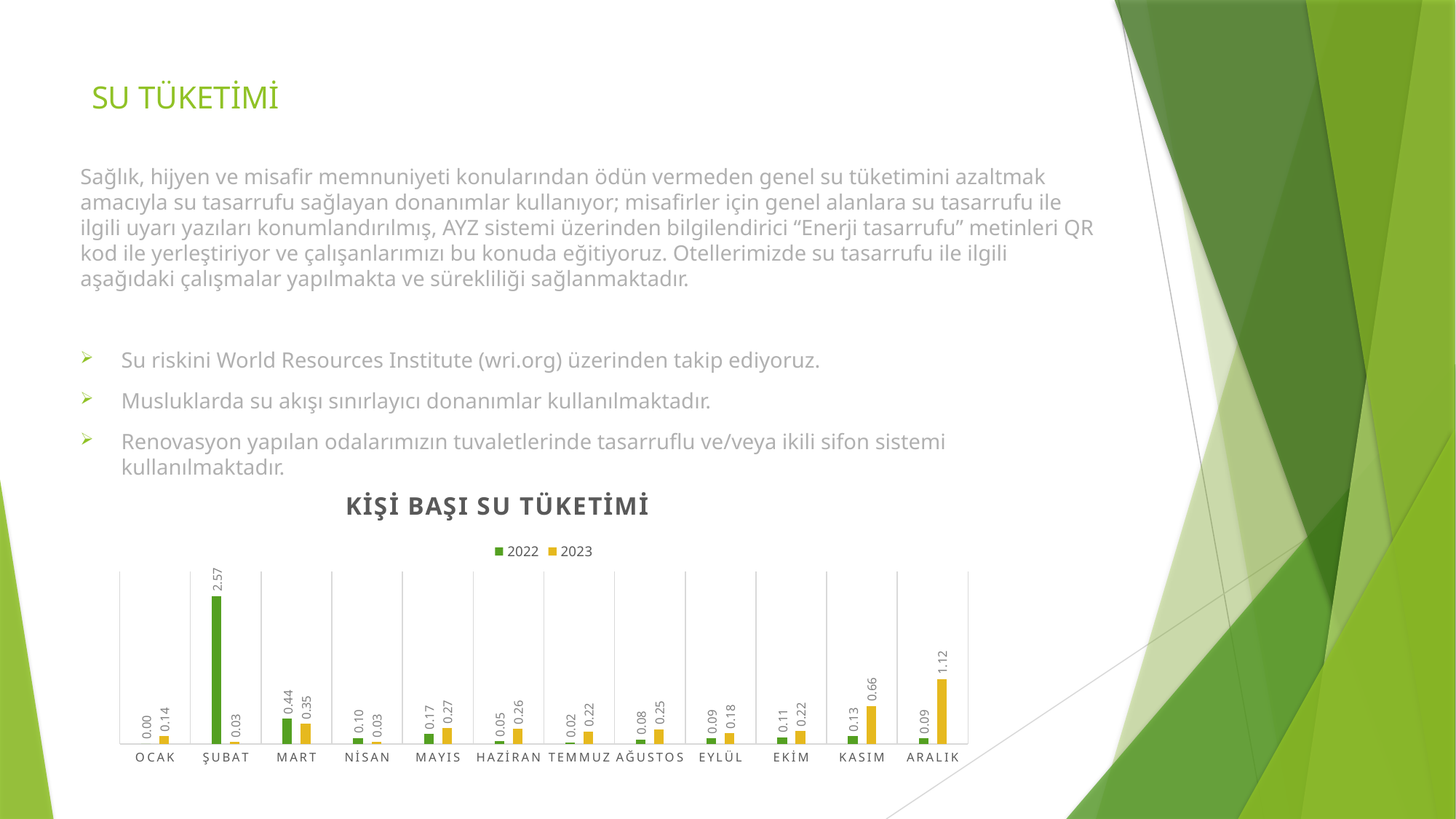
What kind of chart is shown on the slide? bar chart What is the 2023 value for KASIM? 0.66 What is the 2023 value for ARALIK? 1.12 Which month has the highest 2022 value? ŞUBAT What is the title of the chart? KİŞİ BAŞI SU TÜKETİMİ Which month has the lowest 2022 value? OCAK How many series does the legend list? 2 For MART, which is larger, the 2022 value or the 2023 value? 2022 What is the difference between the 2022 and 2023 values for ŞUBAT? 2.54 How many months are shown on the x axis of the chart? 12 Which month has the highest 2023 value? ARALIK What is the 2022 value for ŞUBAT? 2.57